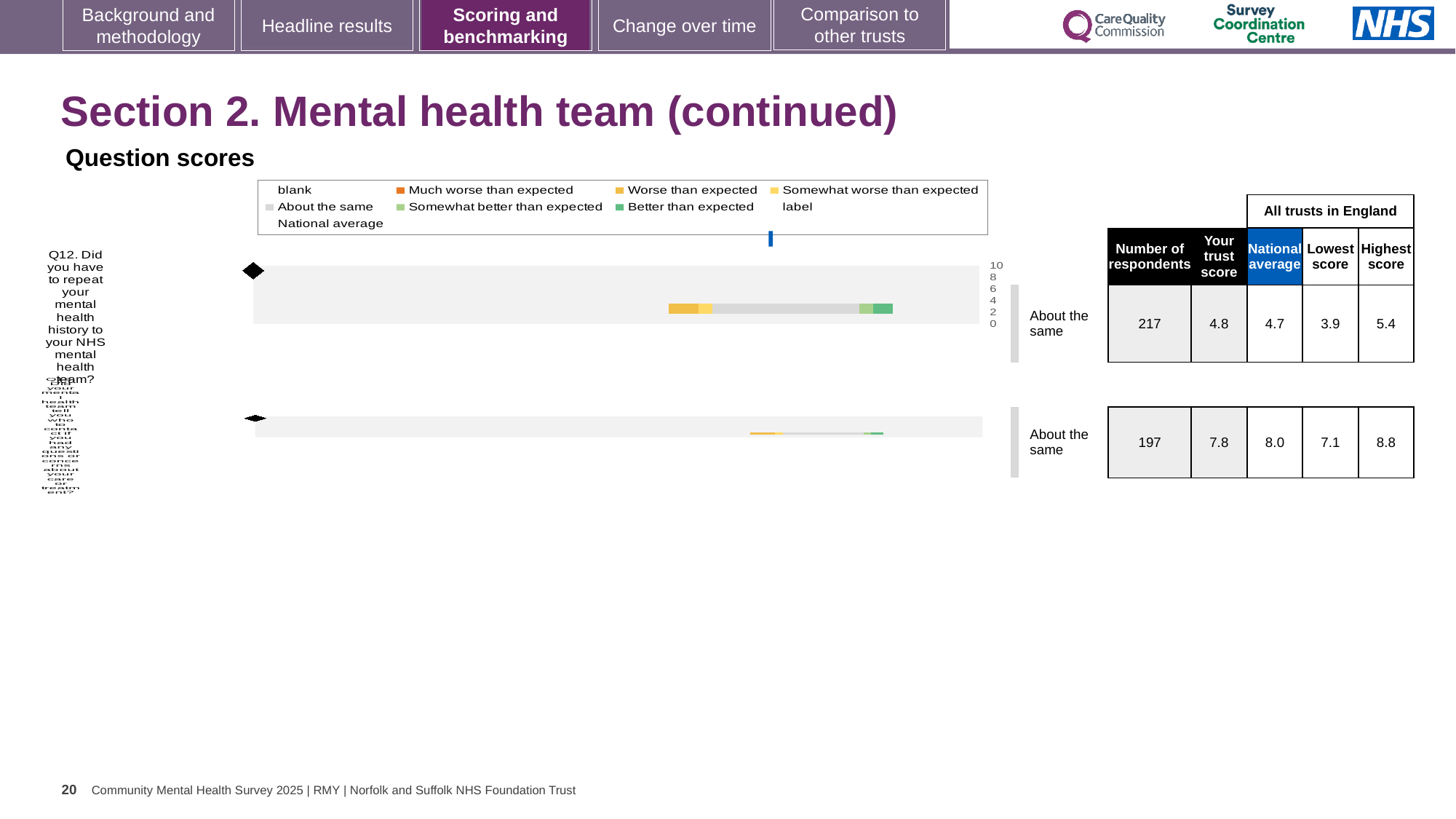
For the lower chart on the slide, what is the difference between the highest score (8.8) and the lowest score (7.1)? 1.7 For Q12 (repeating mental health history), how many respondents are shown? 217 For Q12, what is the difference between the highest and lowest scores among all trusts in England? 1.5 For the lower chart on the slide, which is larger: the trust's score or the national average? the national average What kind of chart is used to show the Q12 benchmarking result? bar chart For Q12, what is the highest score among all trusts in England? 5.4 What benchmarking category is shown next to the Q12 chart? About the same For the lower chart on the slide, what is the trust's score? 7.8 For Q12, what is the trust's score? 4.8 For the lower chart on the slide, how many respondents are shown? 197 For Q12, which is larger: the trust's score or the national average? the trust's score For Q12, what is the national average score? 4.7